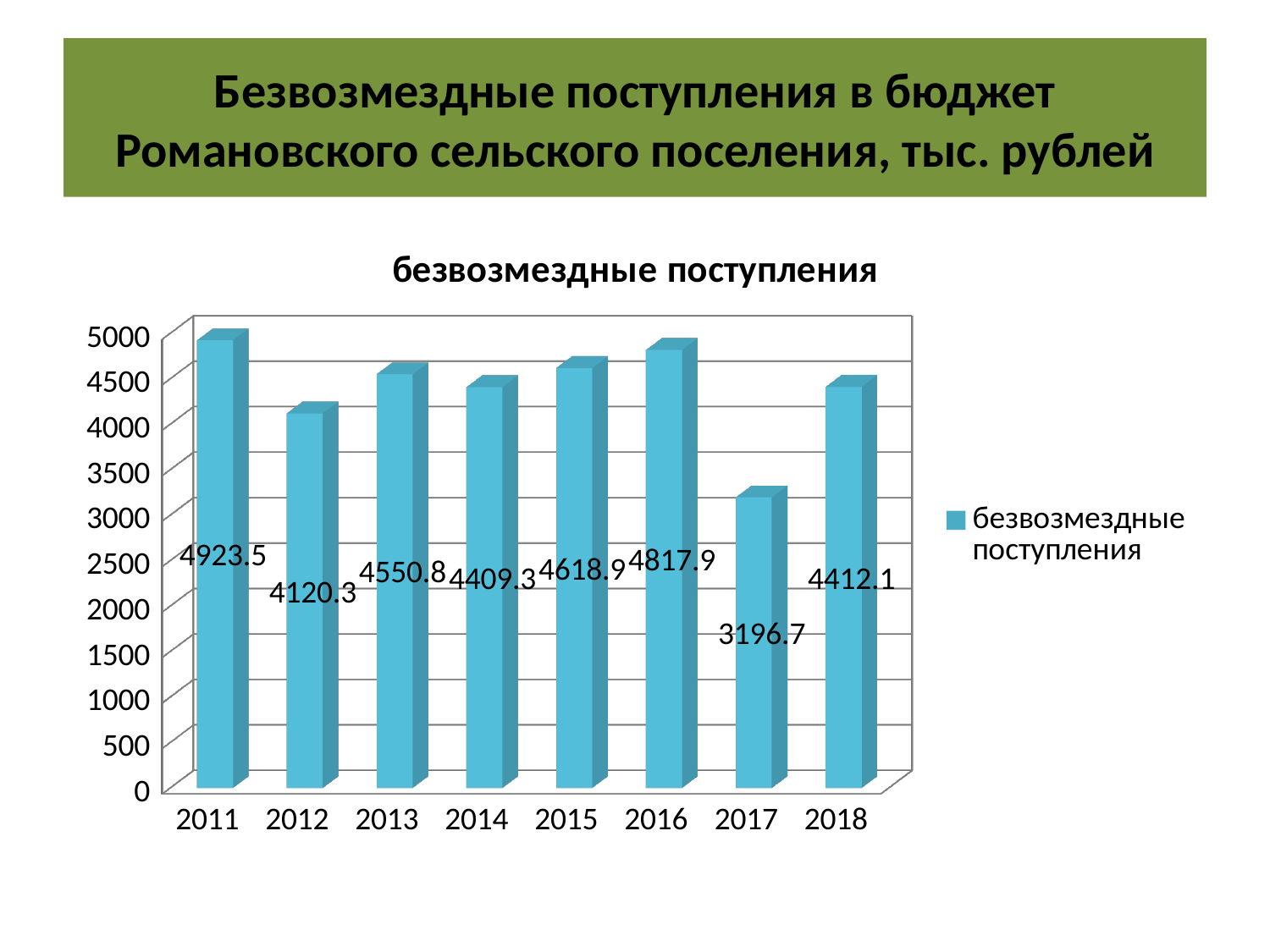
What is the difference between the values for 2016 and 2012? 697.6 What is the title of the chart? безвозмездные поступления How many years are shown on the x axis? 8 Which year has the lowest value? 2017 Which is larger, the value for 2015 or the value for 2012? 2015 What kind of chart is shown? bar chart Which year has the highest value? 2011 What is the value for 2016? 4817.9 What is the value for 2011? 4923.5 What is the difference between the values for 2011 and 2017? 1726.8 Is the value for 2017 greater or less than 3500? less What is the value for 2017? 3196.7